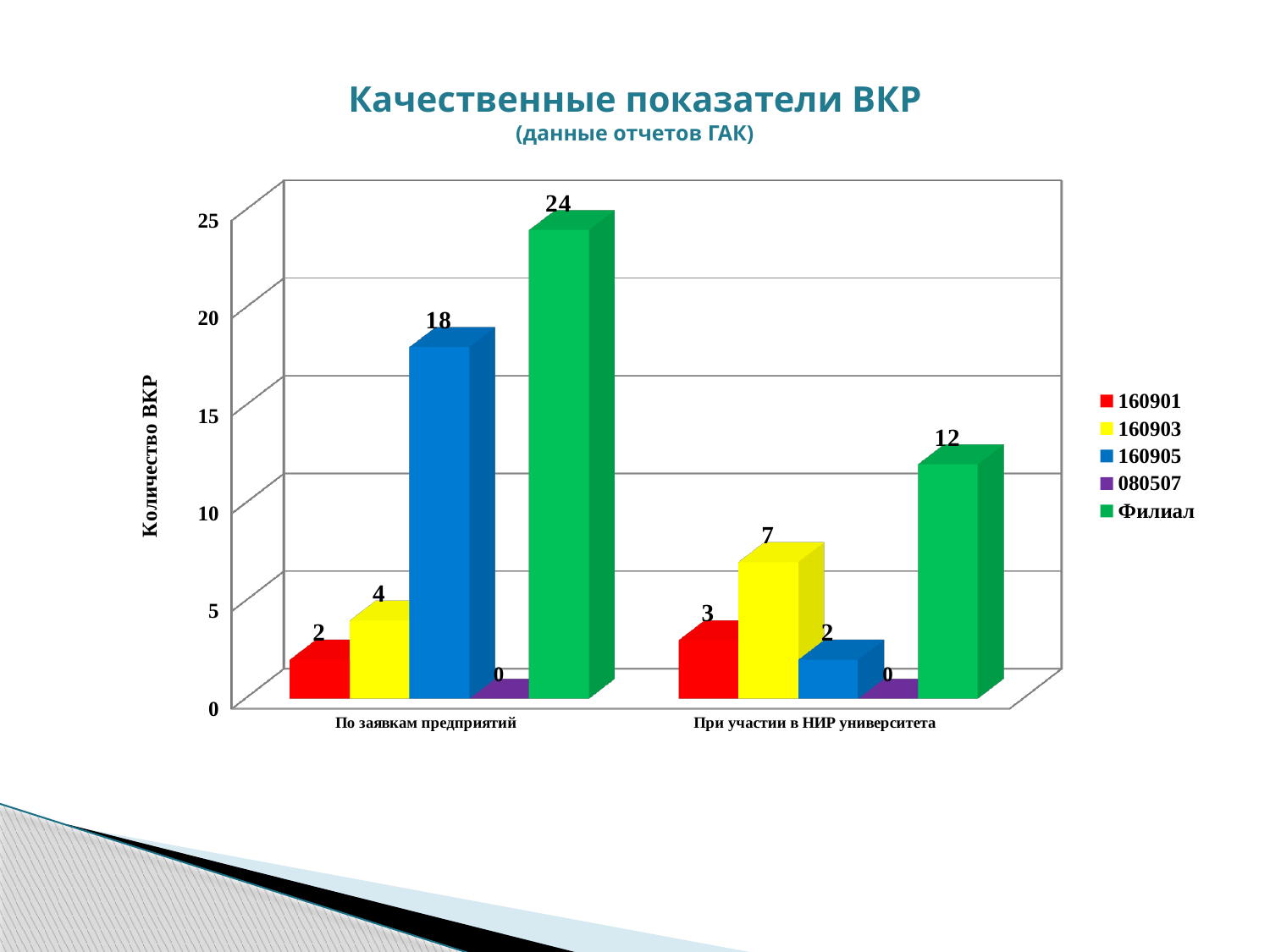
Which series has the highest value in the category По заявкам предприятий? Филиал What is the difference between the Филиал values for По заявкам предприятий and При участии в НИР университета? 12 How many categories are shown on the x axis? 2 Which series has the lowest value in the category При участии в НИР университета? 080507 What is the label of the vertical axis? Количество ВКР What kind of chart is shown on the slide? Bar chart How many series does the legend list? 5 What is the value for 160903 in the category При участии в НИР университета? 7 Which is larger: the value for 160901 in По заявкам предприятий or in При участии в НИР университета? При участии в НИР университета What is the value for Филиал in the category По заявкам предприятий? 24 What is the value for 160905 in the category По заявкам предприятий? 18 What is the value for 080507 in the category При участии в НИР университета? 0